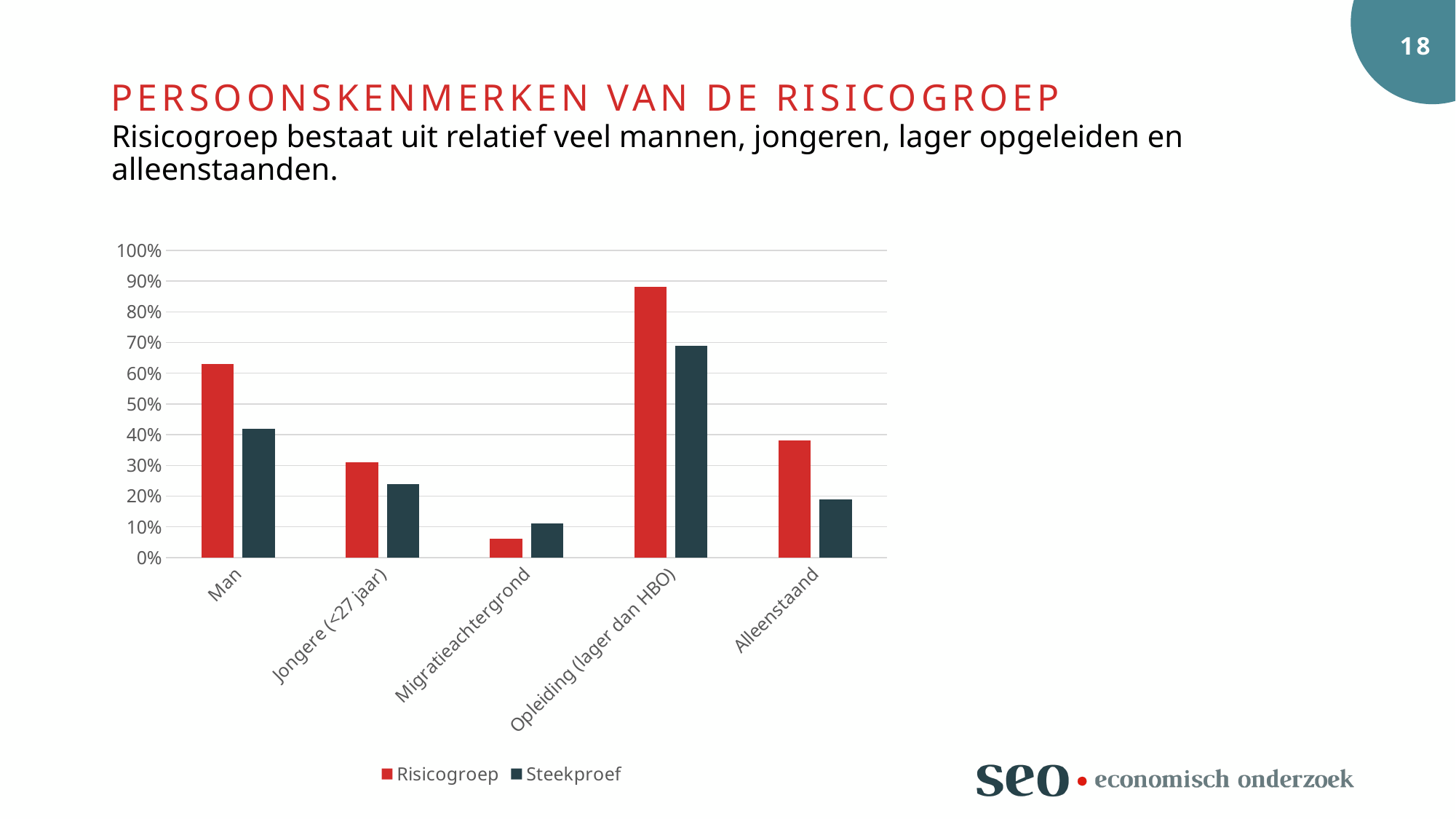
How many series does the legend list? 2 Which colour represents the Risicogroep series in the chart? red Is the Risicogroep value for Man greater or less than 50%? greater For Migratieachtergrond, which series has the larger value, Risicogroep or Steekproef? Steekproef What kind of chart is shown on the slide? bar chart Is the Risicogroep value for Opleiding (lager dan HBO) greater or less than 80%? greater Which category has the highest Risicogroep value? Opleiding (lager dan HBO) Which category has the lowest Risicogroep value? Migratieachtergrond Which category has the lowest Steekproef value? Migratieachtergrond For Alleenstaand, which series has the larger value, Risicogroep or Steekproef? Risicogroep How many categories are shown on the x axis? 5